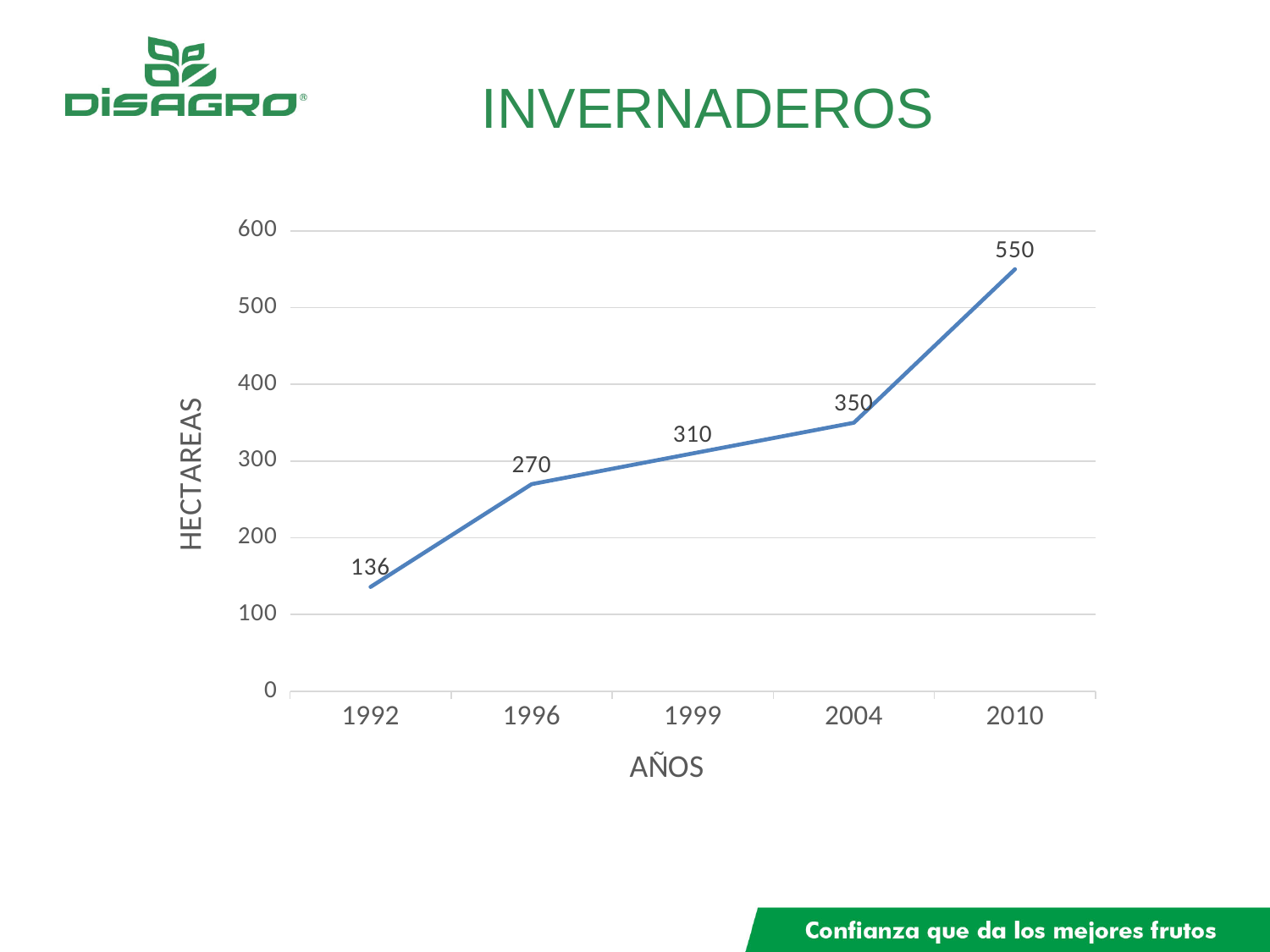
Do the values rise or fall from 1992 to 2010? rise Is the value for 1999 greater or less than 300? greater How many years are plotted on the x axis? 5 Which year has the lowest value? 1992 What is the difference between the values for 1996 and 1992? 134 What kind of chart is shown? line chart What is the difference between the values for 2010 and 2004? 200 What is the value for 1999? 310 Which is larger, the value for 1996 or the value for 2004? 2004 What is the value for 1992? 136 What is the value for 2010? 550 Which year has the highest value? 2010